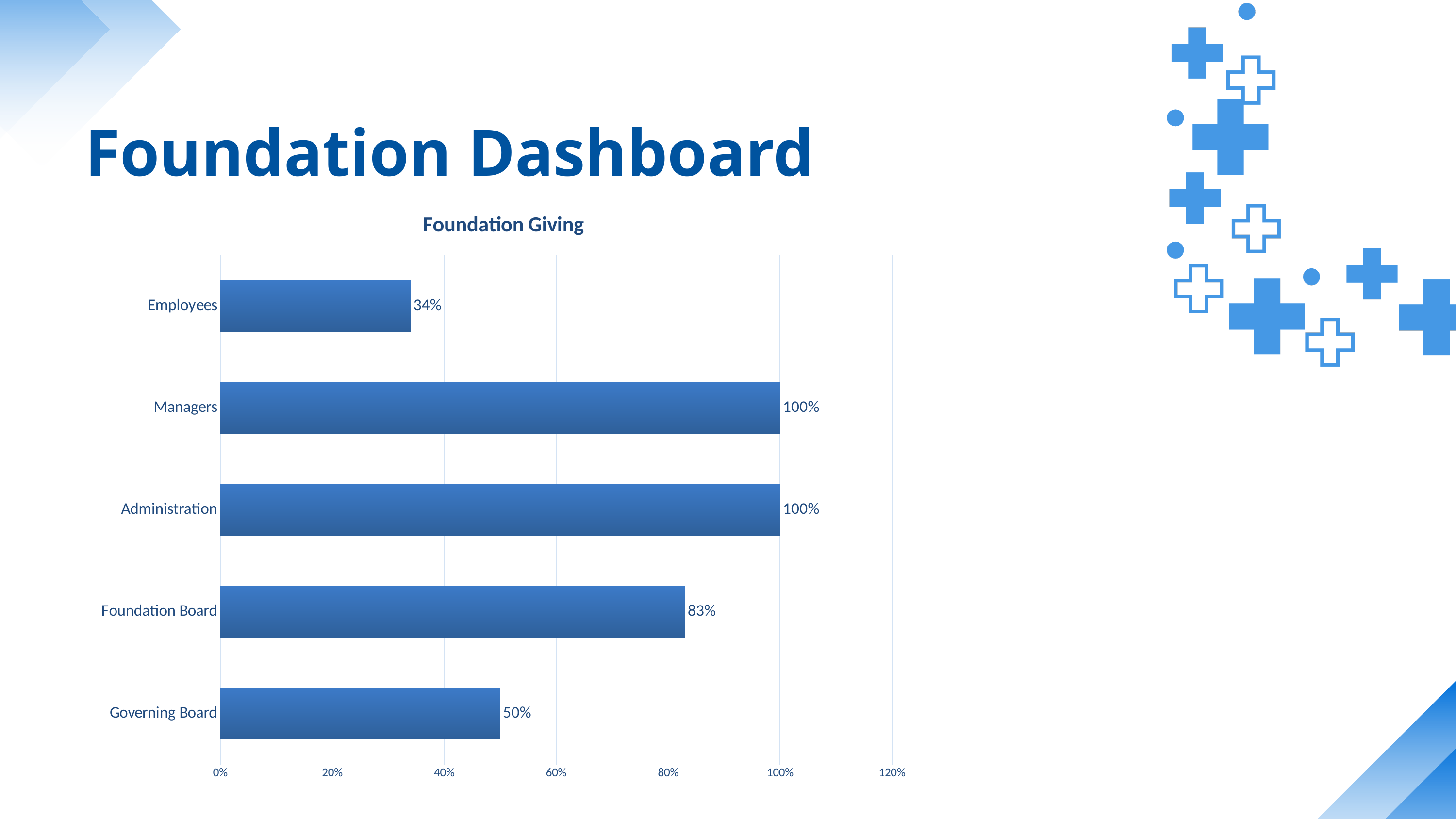
How many categories are shown in the Foundation Giving chart? 5 What is the difference between the values for Administration and Employees? 66% What kind of chart is shown on the slide? Bar chart What is the title of the chart on the slide? Foundation Giving What is the value for Employees in the Foundation Giving chart? 34% Which is larger, the value for Governing Board or the value for Employees? Governing Board What is the value for Governing Board in the Foundation Giving chart? 50% What is the value for Managers in the Foundation Giving chart? 100% What is the value for Foundation Board in the Foundation Giving chart? 83% Which category has the lowest value in the Foundation Giving chart? Employees What is the difference between the values for Foundation Board and Governing Board? 33% Is the value for Foundation Board greater or less than 60%? greater